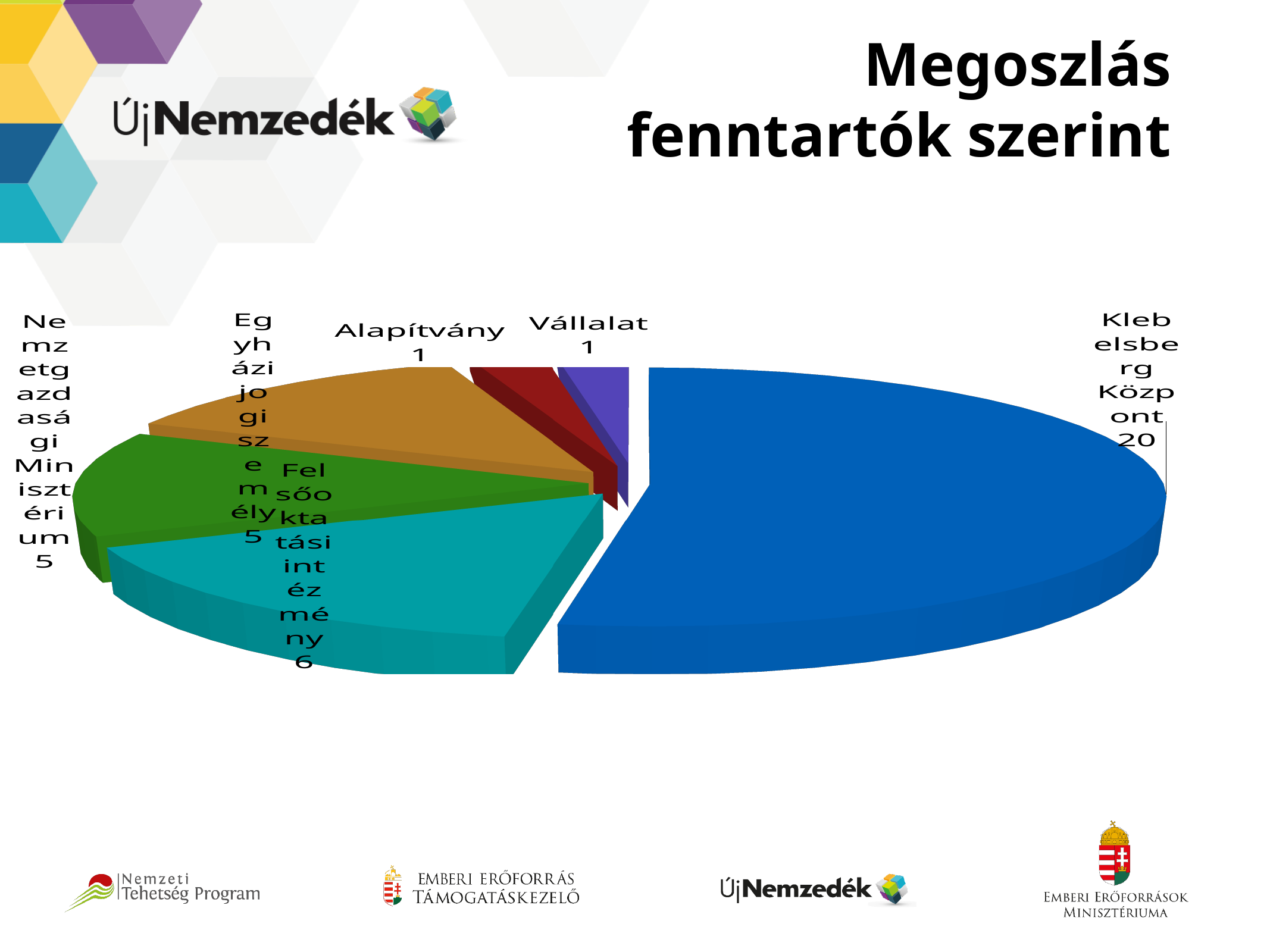
What is the value for Nemzetgazdasági Minisztérium? 5 What is the difference between the values for Klebelsberg Központ and Felsőoktatási intézmény? 14 Which category has the largest slice? Klebelsberg Központ What is the value for Klebelsberg Központ? 20 What colour is the slice for Klebelsberg Központ? blue What is the value for Alapítvány? 1 What is the total of all the values shown in the pie chart? 38 What is the value for Felsőoktatási intézmény? 6 Which is larger, the value for Felsőoktatási intézmény or the value for Egyházi jogi személy? Felsőoktatási intézmény What is the title of the slide containing the chart? Megoszlás fenntartók szerint What kind of chart is shown on the slide? pie chart How many categories does the pie chart show? 6